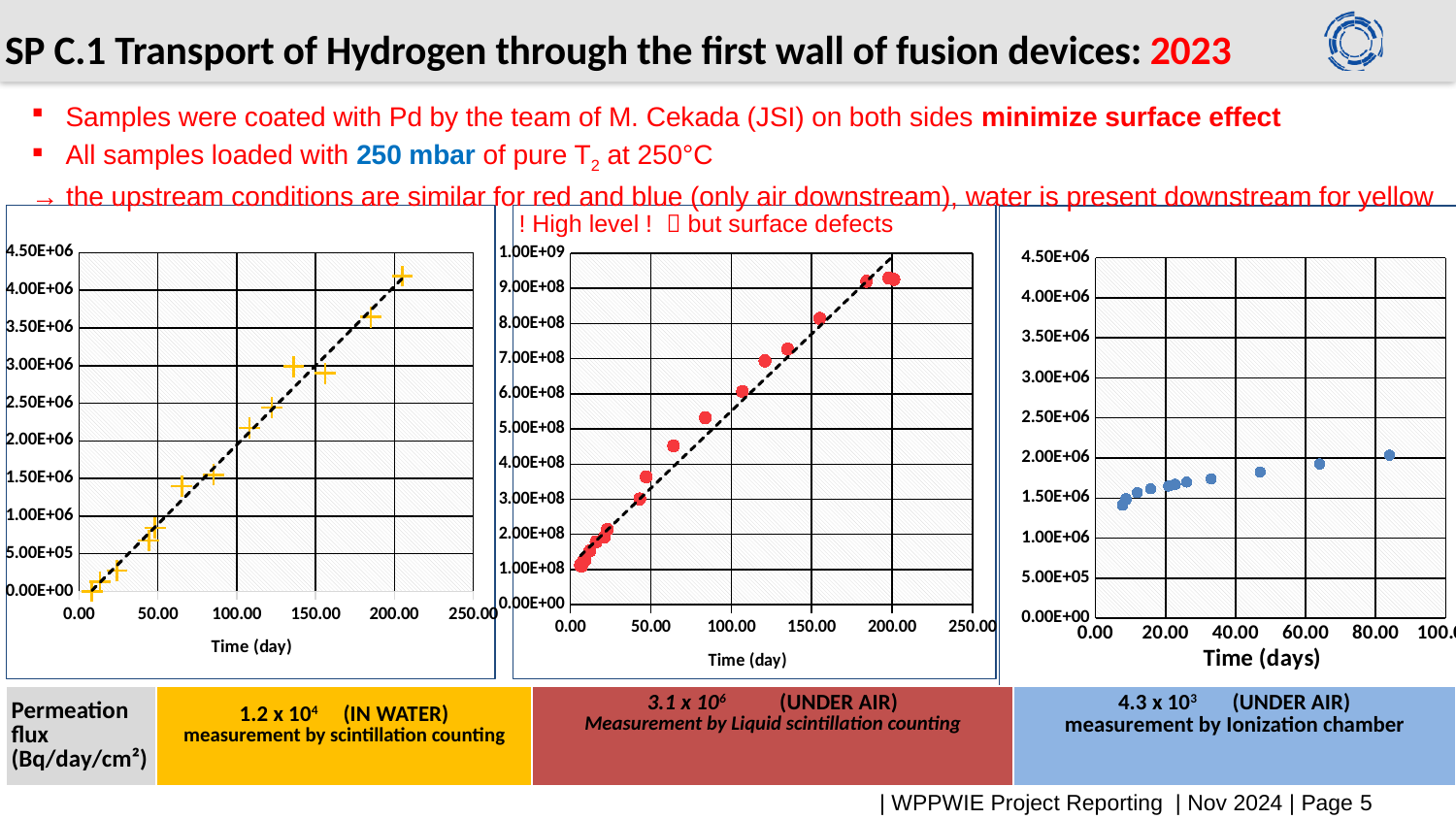
In the middle chart, is the value of the last point (at about 200 days) greater or less than 8.00E+08? greater In the middle chart, is the value of the first point (near 0 days) greater or less than 2.00E+08? less In the right chart, are any of the plotted values greater than 2.50E+06? No In the middle chart, do the plotted values rise or fall along the x axis? rise In the right chart, do the plotted values rise or fall as time increases? rise What kind of chart is the left chart on the slide? scatter chart In the left chart, do the plotted values rise or fall as time increases? rise What is the x-axis title of the right chart? Time (days) What colour are the data markers in the middle chart? red